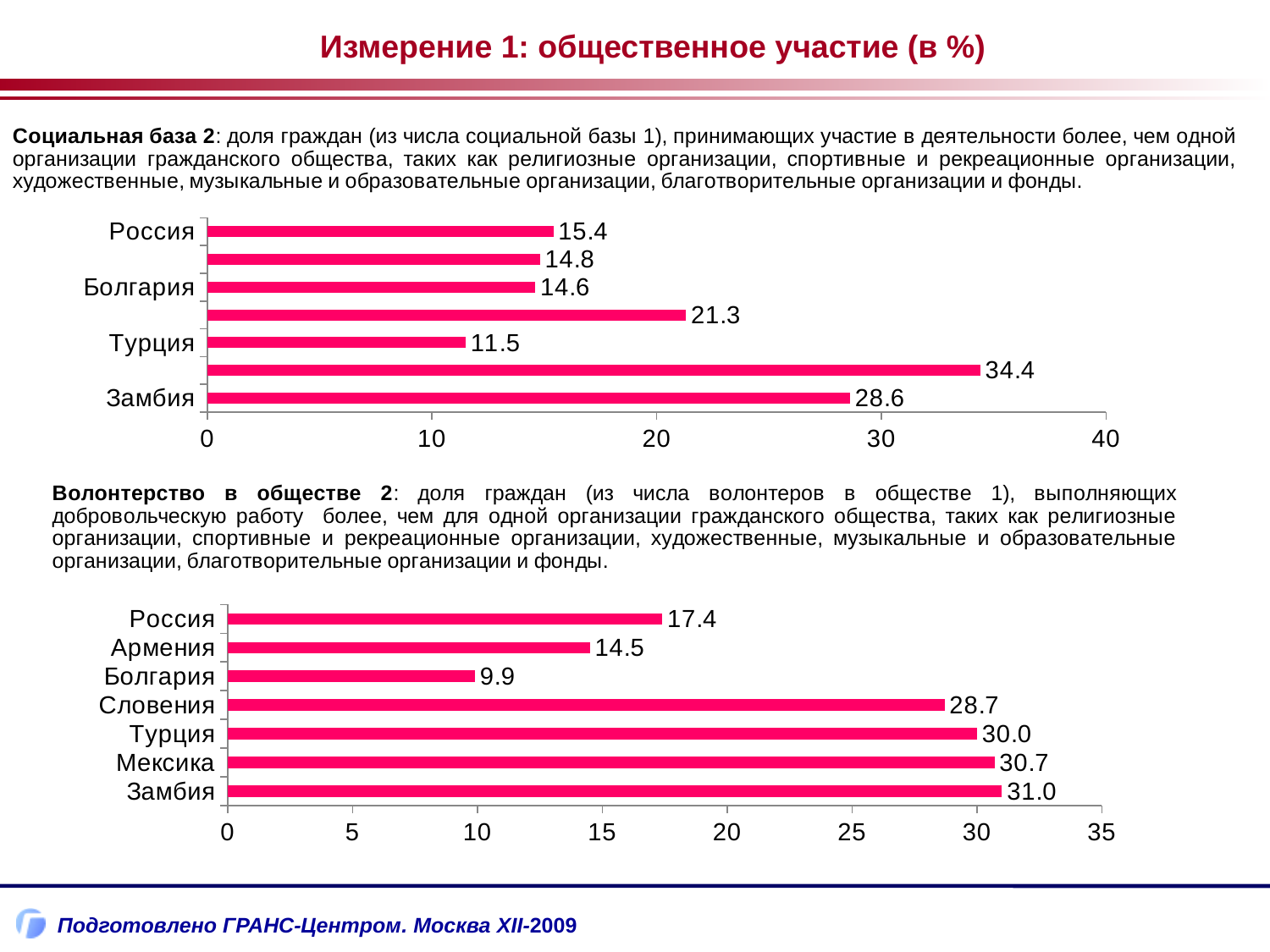
In the bottom chart (Волонтерство в обществе 2), which country has the lowest value? Болгария In the top chart (Социальная база 2), what is the value for Турция? 11.5 In the bottom chart (Волонтерство в обществе 2), which country has the highest value? Замбия In the top chart (Социальная база 2), how many bars are plotted? 7 In the top chart (Социальная база 2), what is the difference between the values for Замбия and Болгария? 14.0 In the bottom chart (Волонтерство в обществе 2), what is the value for Словения? 28.7 In the top chart (Социальная база 2), which labelled country has the lowest value? Турция In the bottom chart (Волонтерство в обществе 2), what is the difference between the values for Мексика and Армения? 16.2 In the bottom chart (Волонтерство в обществе 2), how many countries are shown? 7 What type of chart is the bottom chart (Волонтерство в обществе 2)? Bar chart In the top chart (Социальная база 2), which is larger, the value for Россия or the value for Болгария? Россия In the top chart (Социальная база 2), what is the value for Россия? 15.4